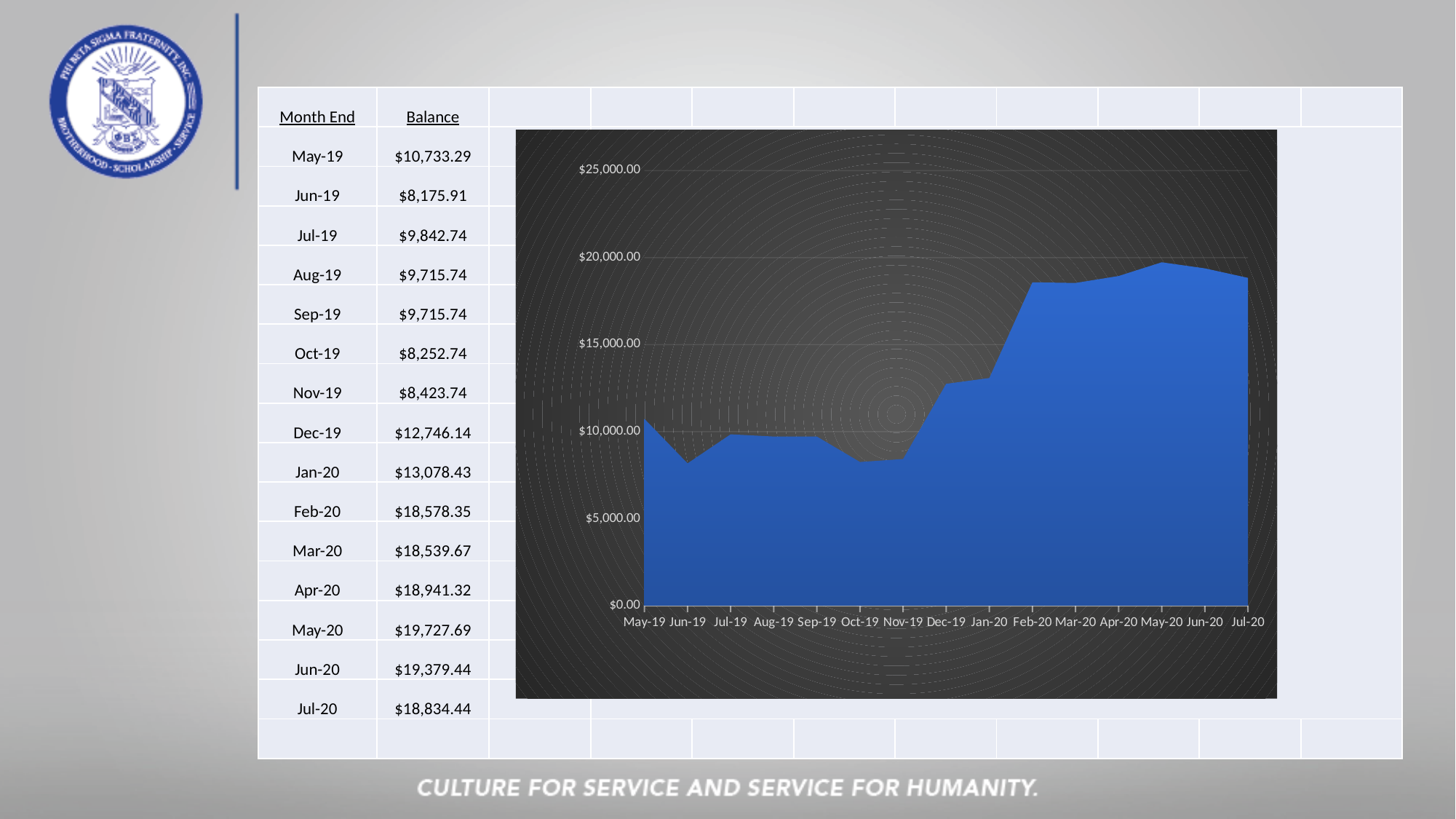
What is the balance for Jun-19? $8,175.91 What is the balance for May-20? $19,727.69 Is the value for Nov-19 greater or less than $10,000.00? less What kind of chart is shown on the slide? area chart How many month-end points are plotted on the chart? 15 Overall, does the balance rise or fall from May-19 to Jul-20? rise Which is larger, the balance for Dec-19 or the balance for Oct-19? Dec-19 Is the value for Feb-20 greater or less than $15,000.00? greater What is the difference between the Feb-20 balance and the Jan-20 balance? $5,499.92 Which month end has the lowest balance? Jun-19 Which month end has the highest balance? May-20 What is the balance for Dec-19? $12,746.14